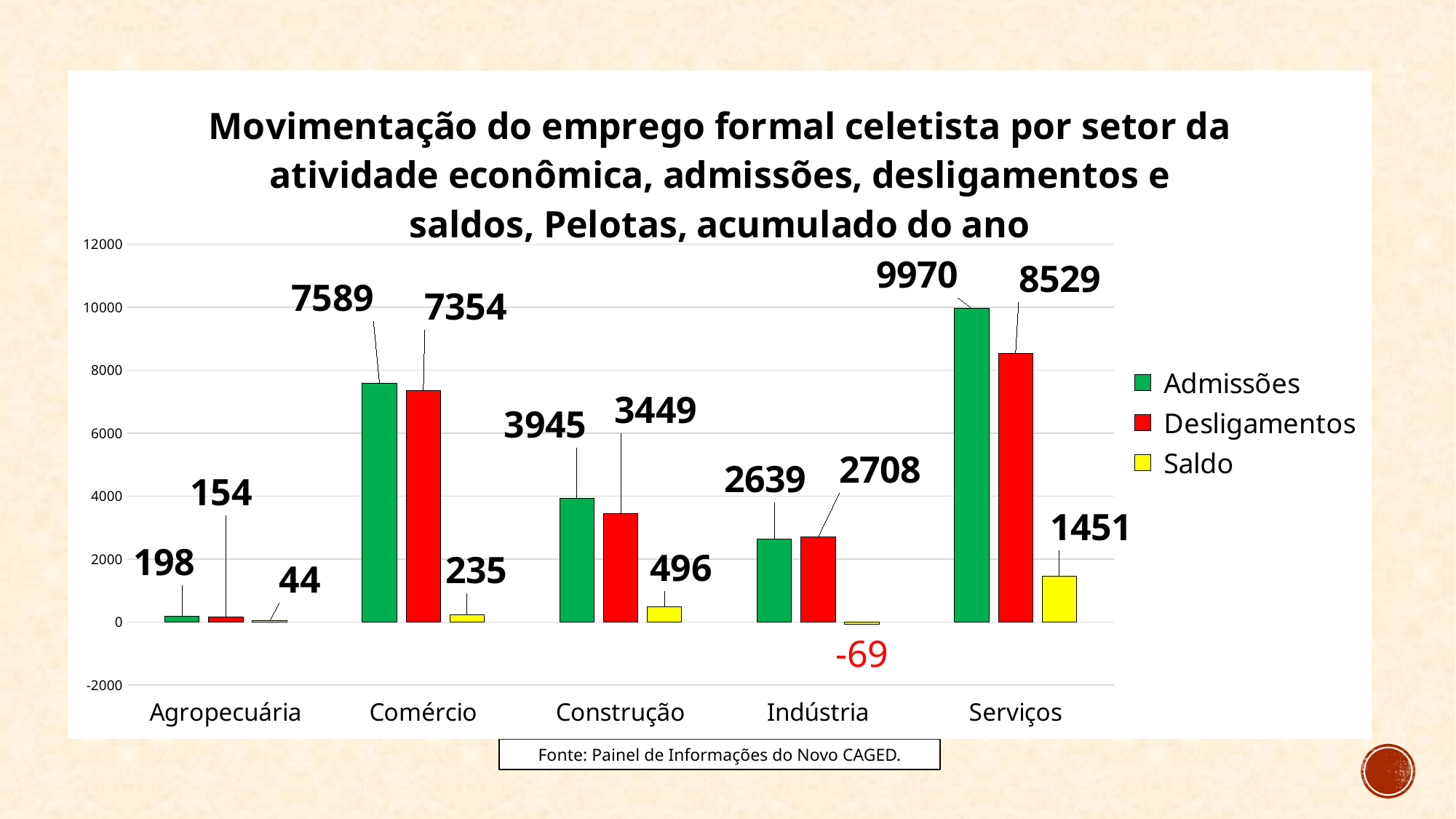
What is the value of Admissões for Comércio? 7589 What kind of chart is shown on the slide? bar chart What is the Saldo value for Indústria? -69 Is the Admissões value for Serviços greater or less than 8000? greater What is the difference between Admissões and Desligamentos for Construção? 496 Which sector has the highest Admissões value? Serviços How many sectors are shown on the x axis? 5 What colour represents the Saldo series in the legend? yellow Which sector has the lowest Saldo value? Indústria Which is larger for Indústria, Admissões or Desligamentos? Desligamentos How many series does the legend list? 3 What is the value of Desligamentos for Serviços? 8529